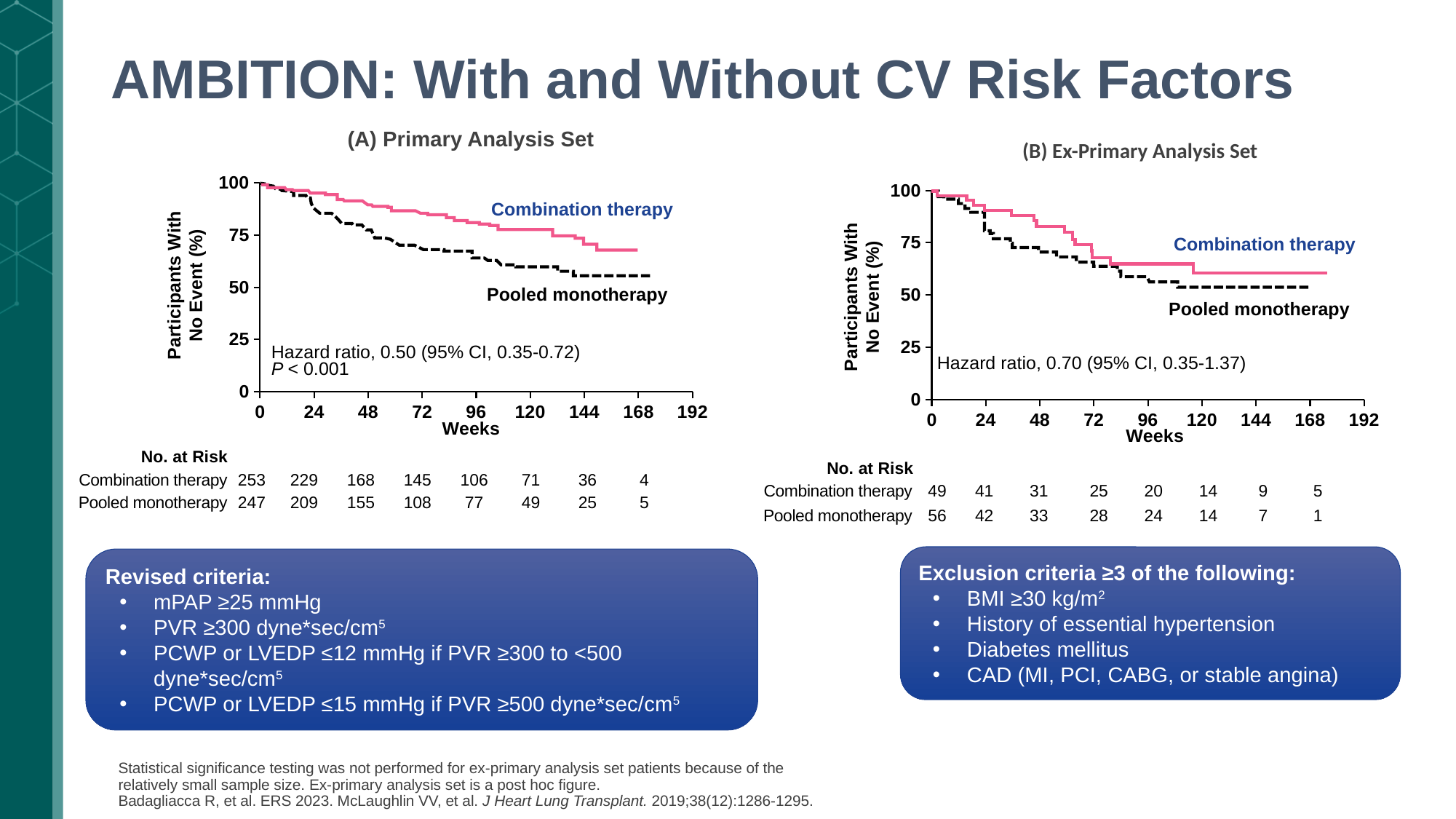
In the (A) Primary Analysis Set chart, is the combination therapy curve at week 96 greater or less than 75? greater In the (A) Primary Analysis Set chart, what is the hazard ratio shown? 0.50 (95% CI, 0.35-0.72) In the (B) Ex-Primary Analysis Set chart, what is the hazard ratio shown? 0.70 (95% CI, 0.35-1.37) In the (B) Ex-Primary Analysis Set chart, is the pooled monotherapy curve at week 144 greater or less than 75? less What kind of chart is the (A) Primary Analysis Set chart? line chart In the (A) Primary Analysis Set chart, how many pooled monotherapy participants were at risk at week 96? 77 In the (B) Ex-Primary Analysis Set chart, which group had more participants at risk at week 168, combination therapy or pooled monotherapy? Combination therapy In the (A) Primary Analysis Set chart, do the curves rise or fall as weeks increase? fall In the (B) Ex-Primary Analysis Set chart, how many pooled monotherapy participants were at risk at week 0? 56 How many series are plotted in the (B) Ex-Primary Analysis Set chart? 2 In the (A) Primary Analysis Set chart, how many combination therapy participants were at risk at week 0? 253 In the (A) Primary Analysis Set chart, what is the difference between the number at risk for combination therapy and pooled monotherapy at week 72? 37